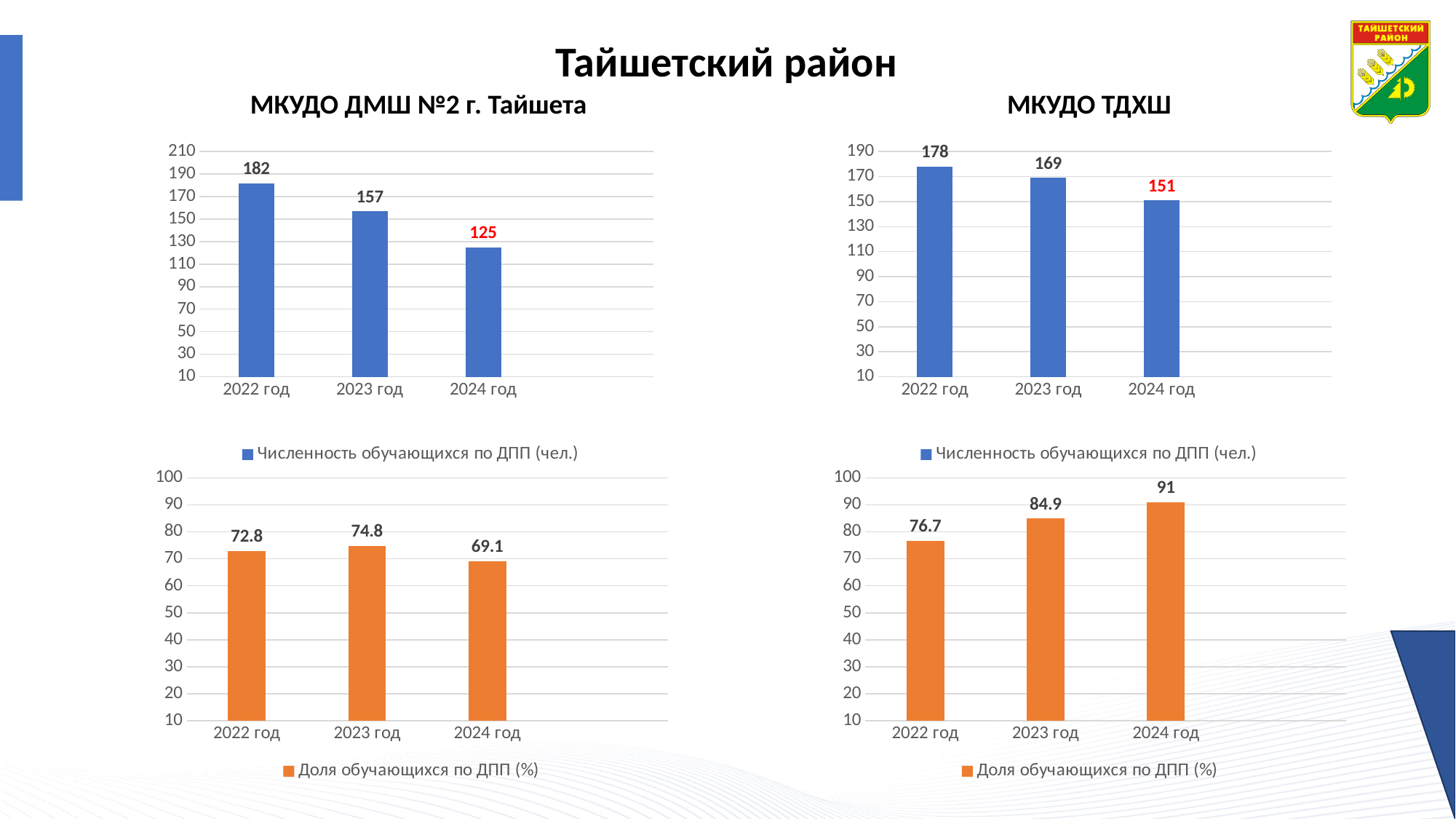
In the bottom-right chart (МКУДО ТДХШ, Доля обучающихся по ДПП), do the values rise or fall from 2022 год to 2024 год? rise In the top-left chart (МКУДО ДМШ №2 г. Тайшета, Численность обучающихся по ДПП), what is the value for 2022 год? 182 Which is larger: the 2024 год value in the bottom-left chart (МКУДО ДМШ №2 г. Тайшета, Доля) or the 2024 год value in the bottom-right chart (МКУДО ТДХШ, Доля)? МКУДО ТДХШ (91) In the top-right chart (МКУДО ТДХШ, Численность обучающихся по ДПП), what is the difference between the 2022 год and 2023 год values? 9 In the bottom-left chart (МКУДО ДМШ №2 г. Тайшета, Доля обучающихся по ДПП), which year has the highest value? 2023 год In the bottom-right chart (МКУДО ТДХШ, Доля обучающихся по ДПП), what is the value for 2024 год? 91 In the bottom-left chart (МКУДО ДМШ №2 г. Тайшета, Доля обучающихся по ДПП), what is the value for 2023 год? 74.8 In the top-left chart (МКУДО ДМШ №2 г. Тайшета, Численность обучающихся по ДПП), which year has the lowest value? 2024 год In the top-left chart (МКУДО ДМШ №2 г. Тайшета, Численность обучающихся по ДПП), what is the difference between the 2022 год and 2024 год values? 57 What type of chart is the top-left chart (МКУДО ДМШ №2 г. Тайшета, Численность обучающихся по ДПП)? bar chart In the top-right chart (МКУДО ТДХШ, Численность обучающихся по ДПП), what is the value for 2023 год? 169 In the top-right chart (МКУДО ТДХШ, Численность обучающихся по ДПП), do the values rise or fall from 2022 год to 2024 год? fall